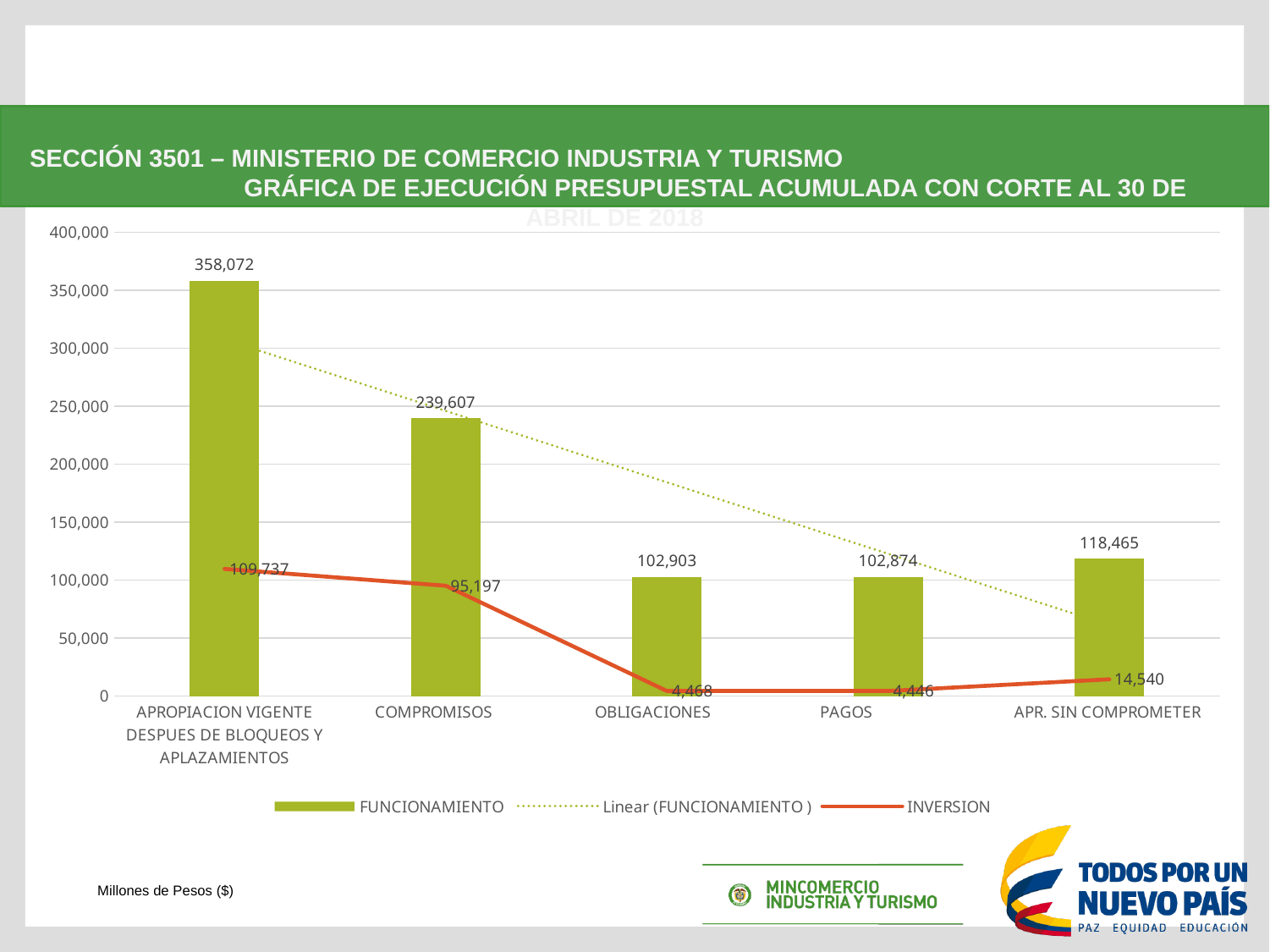
What is the INVERSION value for APR. SIN COMPROMETER? 14,540 What is the FUNCIONAMIENTO value for COMPROMISOS? 239,607 What is the INVERSION value for OBLIGACIONES? 4,468 Which category has the highest FUNCIONAMIENTO value? APROPIACION VIGENTE DESPUES DE BLOQUEOS Y APLAZAMIENTOS How many categories are shown on the x axis? 5 How many entries does the legend list? 3 Which category has the lowest INVERSION value? PAGOS What is the difference between the FUNCIONAMIENTO values for APROPIACION VIGENTE DESPUES DE BLOQUEOS Y APLAZAMIENTOS and COMPROMISOS? 118,465 What is the difference between the INVERSION values for APROPIACION VIGENTE DESPUES DE BLOQUEOS Y APLAZAMIENTOS and COMPROMISOS? 14,540 Which has the larger FUNCIONAMIENTO value, OBLIGACIONES or PAGOS? OBLIGACIONES What unit is stated below the chart for the values? Millones de Pesos ($) What kind of chart is shown on the slide? Combined bar and line chart